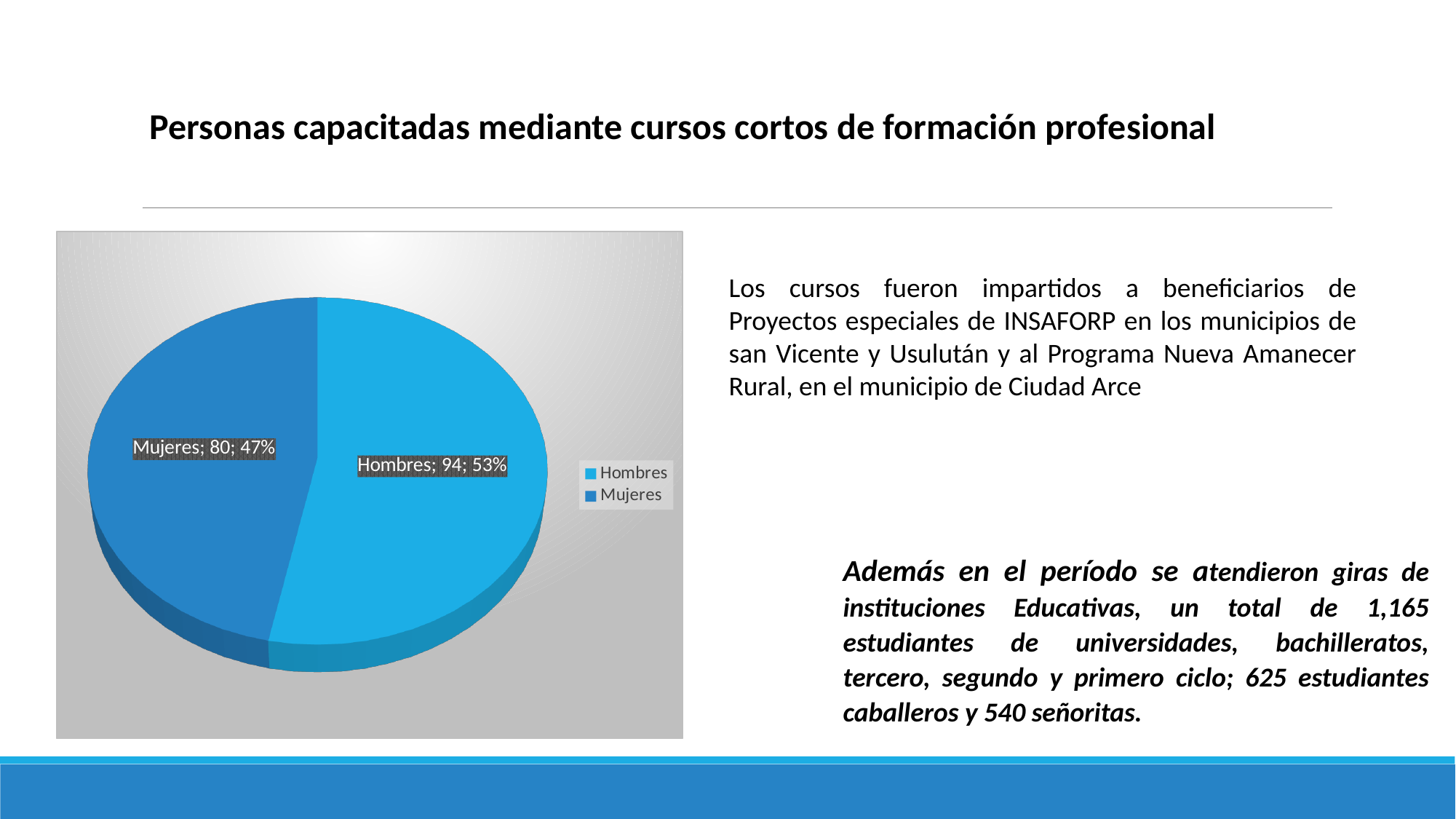
Which category has the largest slice of the pie? Hombres What is the value for Hombres in the pie chart? 94 What kind of chart is shown on the slide? Pie chart What is the value for Mujeres in the pie chart? 80 What percentage share of the pie does Hombres represent? 53% Which category has the smallest slice of the pie? Mujeres What is the difference between the values for Hombres and Mujeres? 14 What entries does the legend of the pie chart list? Hombres, Mujeres How many categories does the pie chart show? 2 Which is larger, the value for Hombres or the value for Mujeres? Hombres What is the total of the two values shown in the pie chart? 174 What percentage share of the pie does Mujeres represent? 47%